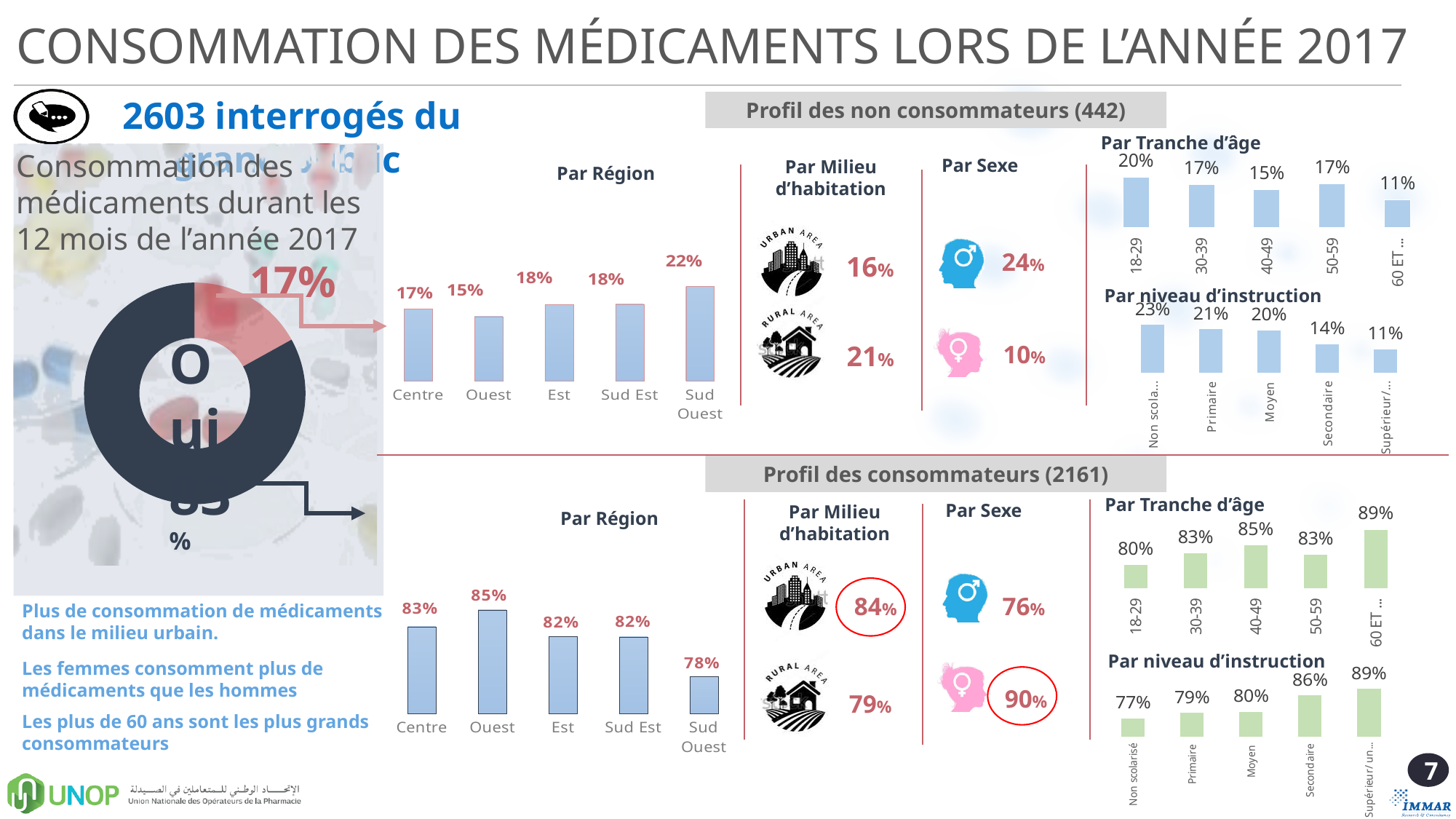
In the 'Par Tranche d'âge' bar chart under 'Profil des consommateurs', what is the value for the 40-49 age group? 85% In the 'Par Région' bar chart under 'Profil des consommateurs', which region has the highest value? Ouest In the 'Par niveau d'instruction' bar chart under 'Profil des non consommateurs', which category is larger: Primaire or Secondaire? Primaire In the 'Par niveau d'instruction' bar chart under 'Profil des consommateurs', what is the value for Secondaire? 86% In the 'Par Tranche d'âge' bar chart under 'Profil des non consommateurs', which age group has the lowest value? 60 ET ... In the donut chart on the left, what share of respondents answered 'Oui'? 83% What type of chart is used for 'Par Tranche d'âge' under 'Profil des consommateurs'? bar chart In the 'Par Région' bar chart under 'Profil des consommateurs', what is the difference between the values for Centre and Sud Ouest? 5% How many bars are in the 'Par Région' bar chart under 'Profil des consommateurs'? 5 In the 'Par niveau d'instruction' bar chart under 'Profil des consommateurs', do the values rise or fall from Non scolarisé to Supérieur? rise In the 'Par Région' bar chart under 'Profil des non consommateurs', what is the value for Sud Ouest? 22% In the 'Par Région' bar chart under 'Profil des non consommateurs', which region has the lowest value? Ouest